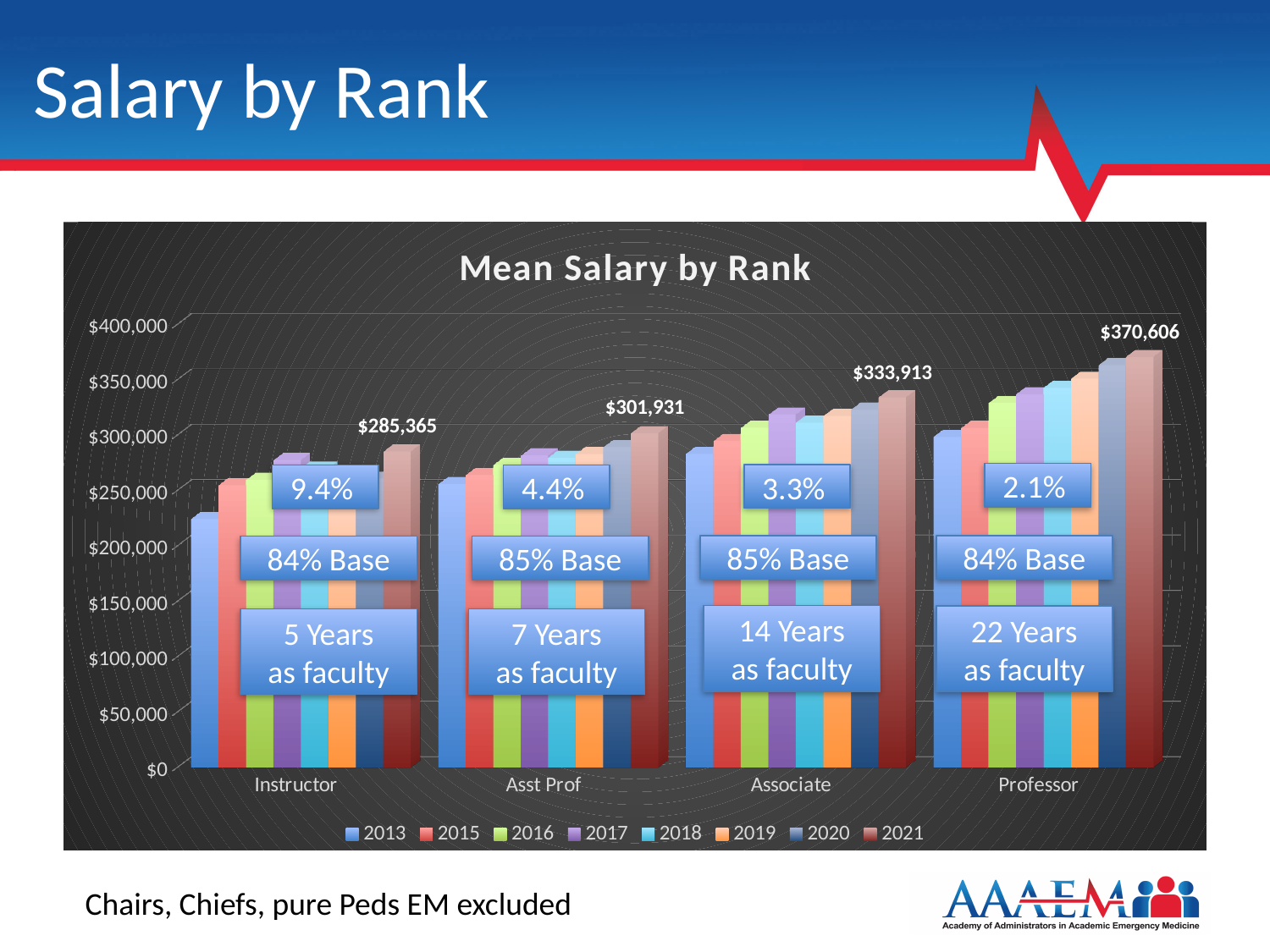
What is the title of the chart? Mean Salary by Rank What is the 2021 mean salary for Asst Prof? $301,931 Which rank has the lowest 2021 mean salary? Instructor Which rank has the highest 2021 mean salary? Professor How many series does the chart's legend list? 8 How many rank categories are shown on the x axis of the chart? 4 What type of chart is shown on the slide? bar chart What is the 2021 mean salary for Instructor? $285,365 What is the 2021 mean salary for Associate? $333,913 Is the 2013 mean salary for Instructor greater or less than $250,000? less What is the difference between the 2021 mean salary for Professor and for Instructor? $85,241 What is the 2021 mean salary for Professor? $370,606